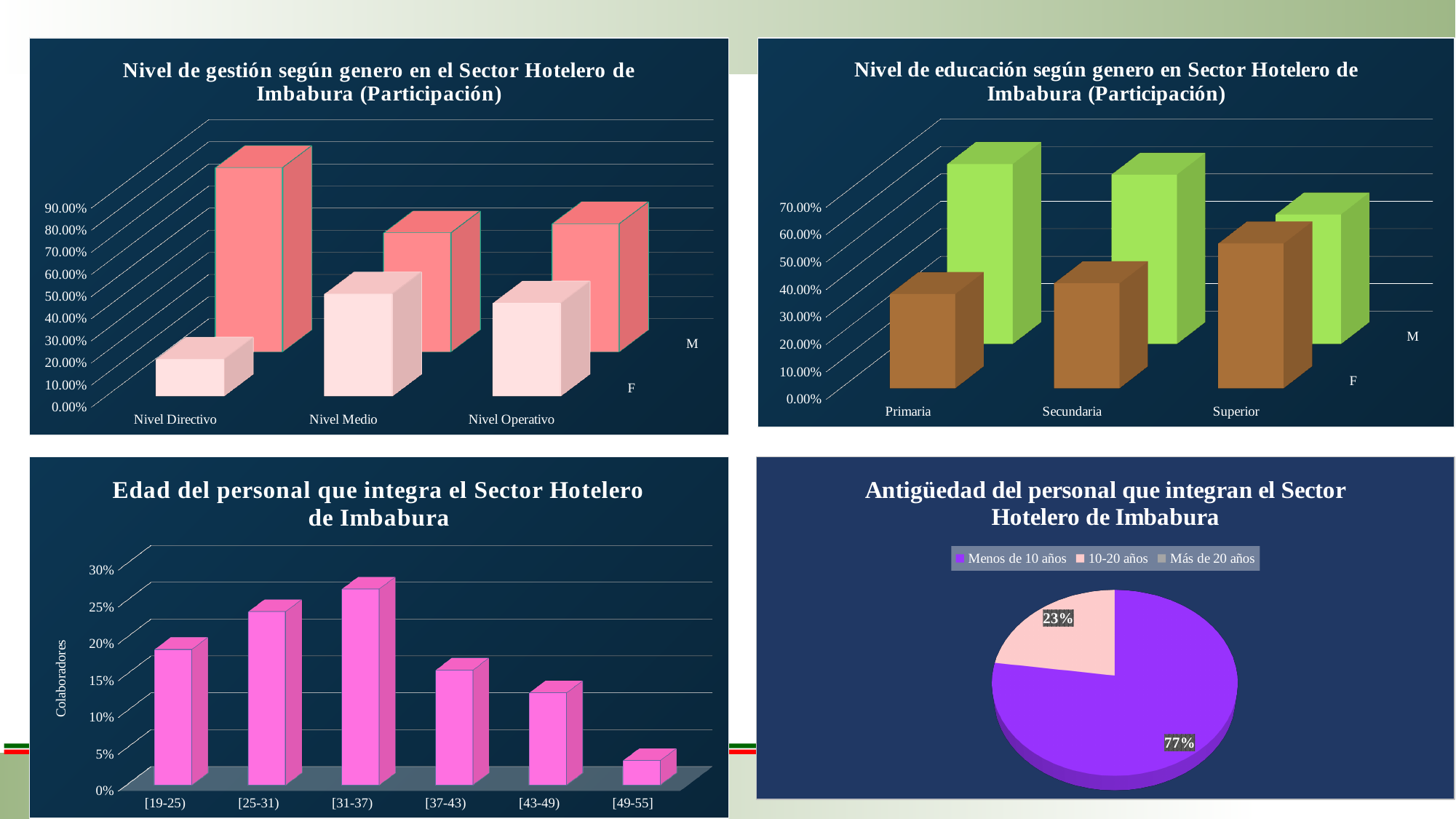
In the chart 'Edad del personal que integra el Sector Hotelero de Imbabura', which age range has the highest bar? [31-37) What kind of chart is 'Edad del personal que integra el Sector Hotelero de Imbabura'? Bar chart How many age categories are shown in the chart 'Edad del personal que integra el Sector Hotelero de Imbabura'? 6 How many entries does the legend of the chart 'Antigüedad del personal que integran el Sector Hotelero de Imbabura' list? 3 In the pie chart 'Antigüedad del personal que integran el Sector Hotelero de Imbabura', what share is labelled for 'Menos de 10 años'? 77% What kind of chart is 'Antigüedad del personal que integran el Sector Hotelero de Imbabura'? Pie chart In the pie chart 'Antigüedad del personal que integran el Sector Hotelero de Imbabura', how many percentage points larger is the 'Menos de 10 años' slice than the '10-20 años' slice? 54 percentage points In the chart 'Edad del personal que integra el Sector Hotelero de Imbabura', is the value for [31-37) greater or less than 20%? greater In the chart 'Nivel de gestión según genero en el Sector Hotelero de Imbabura (Participación)', which series has the larger value for Nivel Directivo, F or M? M In the chart 'Nivel de educación según genero en Sector Hotelero de Imbabura (Participación)', how many education levels are shown on the x axis? 3 In the chart 'Edad del personal que integra el Sector Hotelero de Imbabura', which age range has the lowest bar? [49-55] In the pie chart 'Antigüedad del personal que integran el Sector Hotelero de Imbabura', what share is labelled for '10-20 años'? 23%